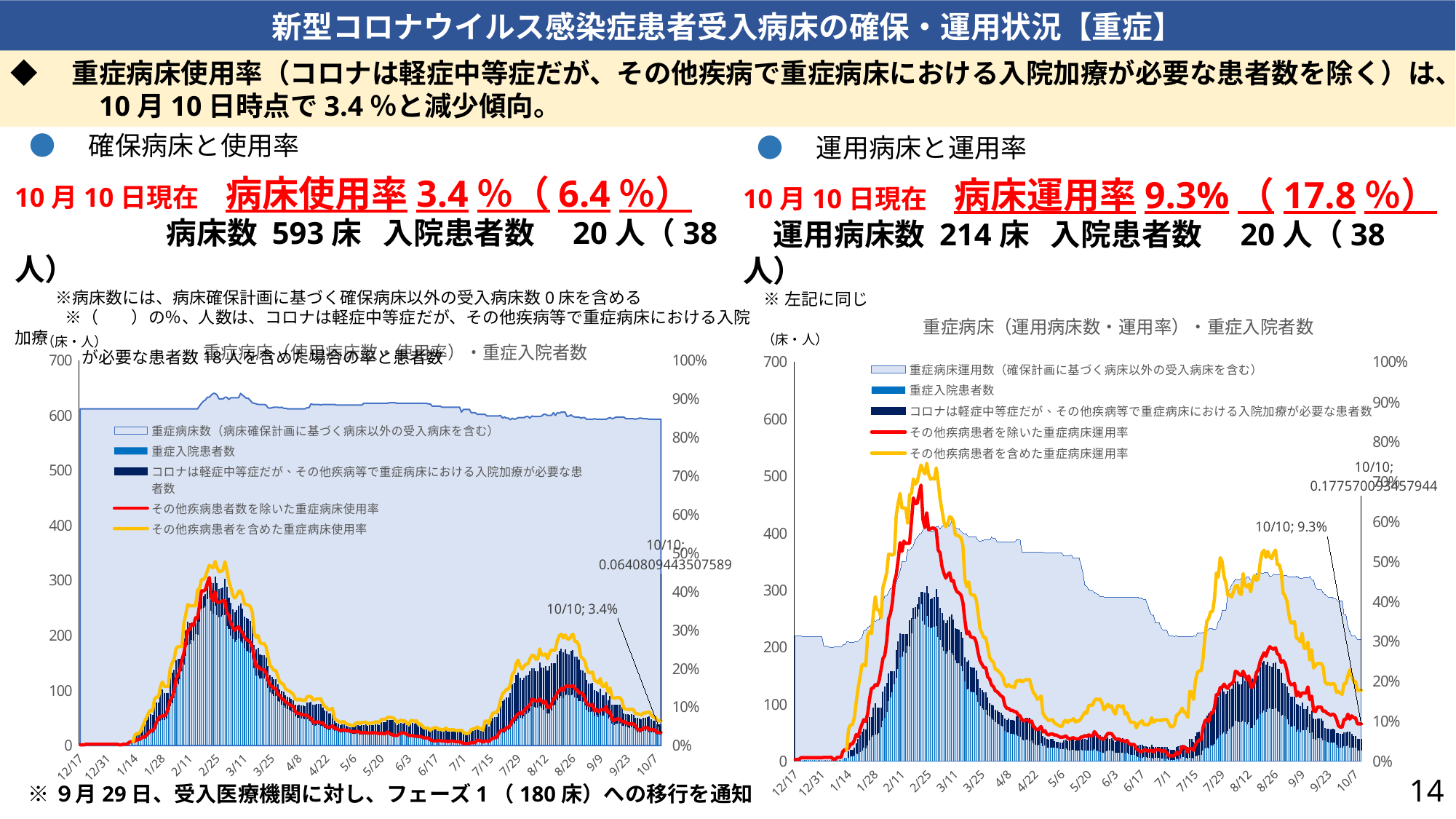
In the right chart, is the 重症病床運用数 value at 2/25 greater or less than 300? greater In the right chart, what value is printed in the data label for 10/10 on the その他疾病患者を含めた重症病床運用率 line? 0.177570093457944 In the right chart (重症病床（運用病床数・運用率）・重症入院者数), what value is labelled for 10/10 on the その他疾病患者を除いた重症病床運用率 line? 9.3% In the right chart, does the その他疾病患者を含めた重症病床運用率 line rise or fall between 8/26 and 10/7? fall What kind of chart is the right chart? Combined bar and line chart In the right chart, on 10/10 which is larger: その他疾病患者を除いた重症病床運用率 or その他疾病患者を含めた重症病床運用率? その他疾病患者を含めた重症病床運用率 How many series does the legend of the left chart list? 5 In the left chart, what value is printed in the data label for 10/10 on the その他疾病患者を含めた重症病床使用率 line? 0.0640809443507589 In the left chart, is the 重症病床数 value at 10/7 greater or less than 500? greater In the left chart, what value is labelled for 10/10 on the その他疾病患者数を除いた重症病床使用率 line? 3.4% What is the title of the right chart? 重症病床（運用病床数・運用率）・重症入院者数 How many series does the legend of the right chart list? 5